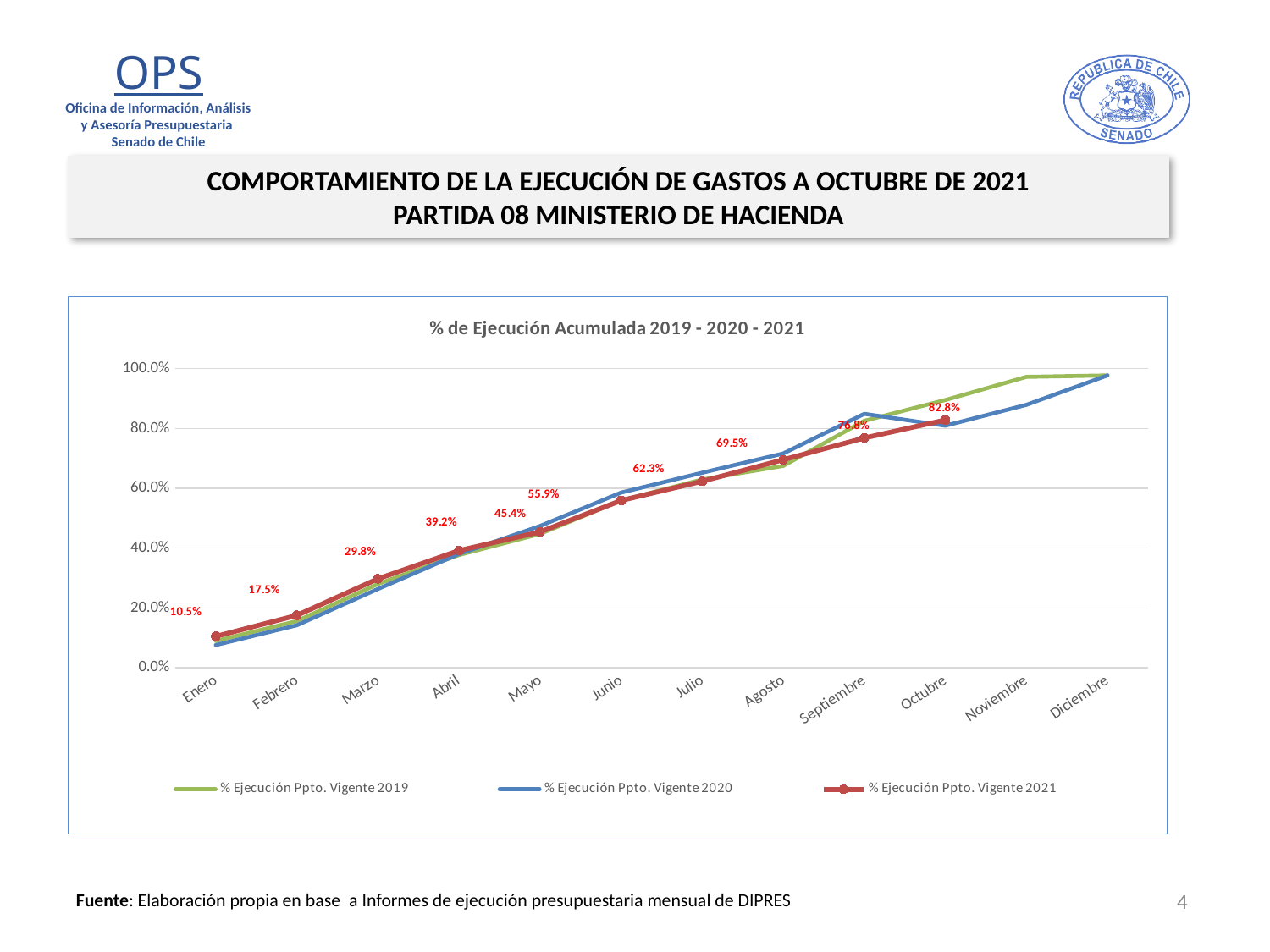
Is the value for % Ejecución Ppto. Vigente 2020 in Noviembre greater or less than 80.0%? greater What is the value for % Ejecución Ppto. Vigente 2021 in Marzo? 29.8% How many months are shown along the x axis? 12 Which month has the highest labelled value for % Ejecución Ppto. Vigente 2021? Octubre What is the value for % Ejecución Ppto. Vigente 2021 in Enero? 10.5% What type of chart is shown on the slide? line chart What is the title of the chart? % de Ejecución Acumulada 2019 - 2020 - 2021 Do the values for % Ejecución Ppto. Vigente 2021 rise or fall from Enero to Octubre? rise How many series does the legend list? 3 What is the value for % Ejecución Ppto. Vigente 2021 in Junio? 55.9% What is the difference between the % Ejecución Ppto. Vigente 2021 values for Octubre and Enero? 72.3% What is the value for % Ejecución Ppto. Vigente 2021 in Octubre? 82.8%